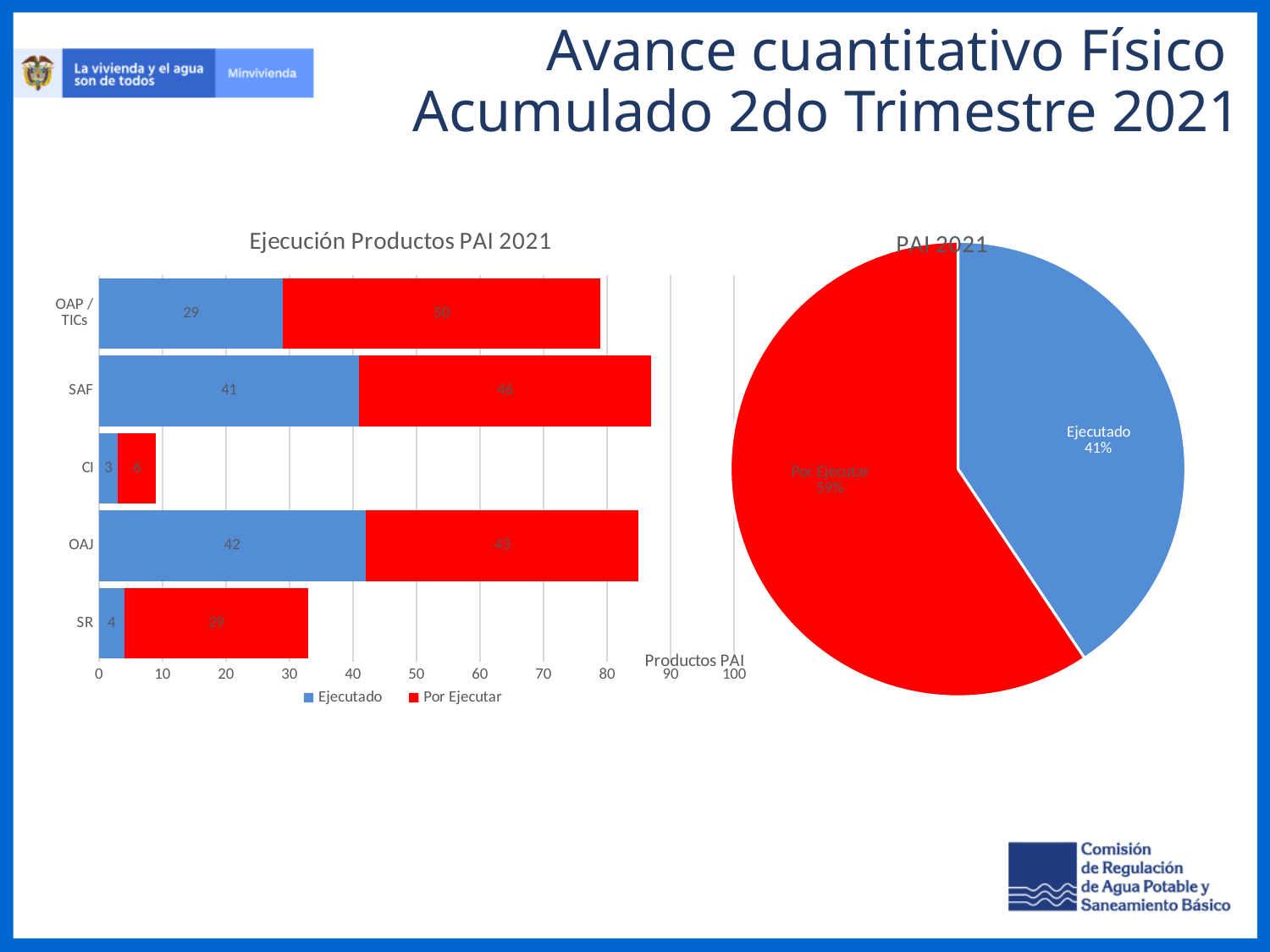
In the 'Ejecución Productos PAI 2021' chart, what is the Ejecutado value for SAF? 41 In the 'Ejecución Productos PAI 2021' chart, what is the Por Ejecutar value for OAP / TICs? 50 In the 'Ejecución Productos PAI 2021' chart, which category has the lowest Ejecutado value? CI In the 'Ejecución Productos PAI 2021' chart, what is the difference between the Por Ejecutar and Ejecutado values for OAP / TICs? 21 In the 'PAI 2021' pie chart, what share is Por Ejecutar? 59% How many series does the legend of the 'Ejecución Productos PAI 2021' chart list? 2 In the 'Ejecución Productos PAI 2021' chart, is the Ejecutado value for SAF larger or the Ejecutado value for OAP / TICs? SAF How many categories are shown in the 'Ejecución Productos PAI 2021' chart? 5 What kind of chart is the 'PAI 2021' chart on the right? Pie chart In the 'Ejecución Productos PAI 2021' chart, which category has the highest Ejecutado value? OAJ In the 'Ejecución Productos PAI 2021' chart, what is the Ejecutado value for SR? 4 In the 'Ejecución Productos PAI 2021' chart, what is the total of the stacked bar for OAJ? 85